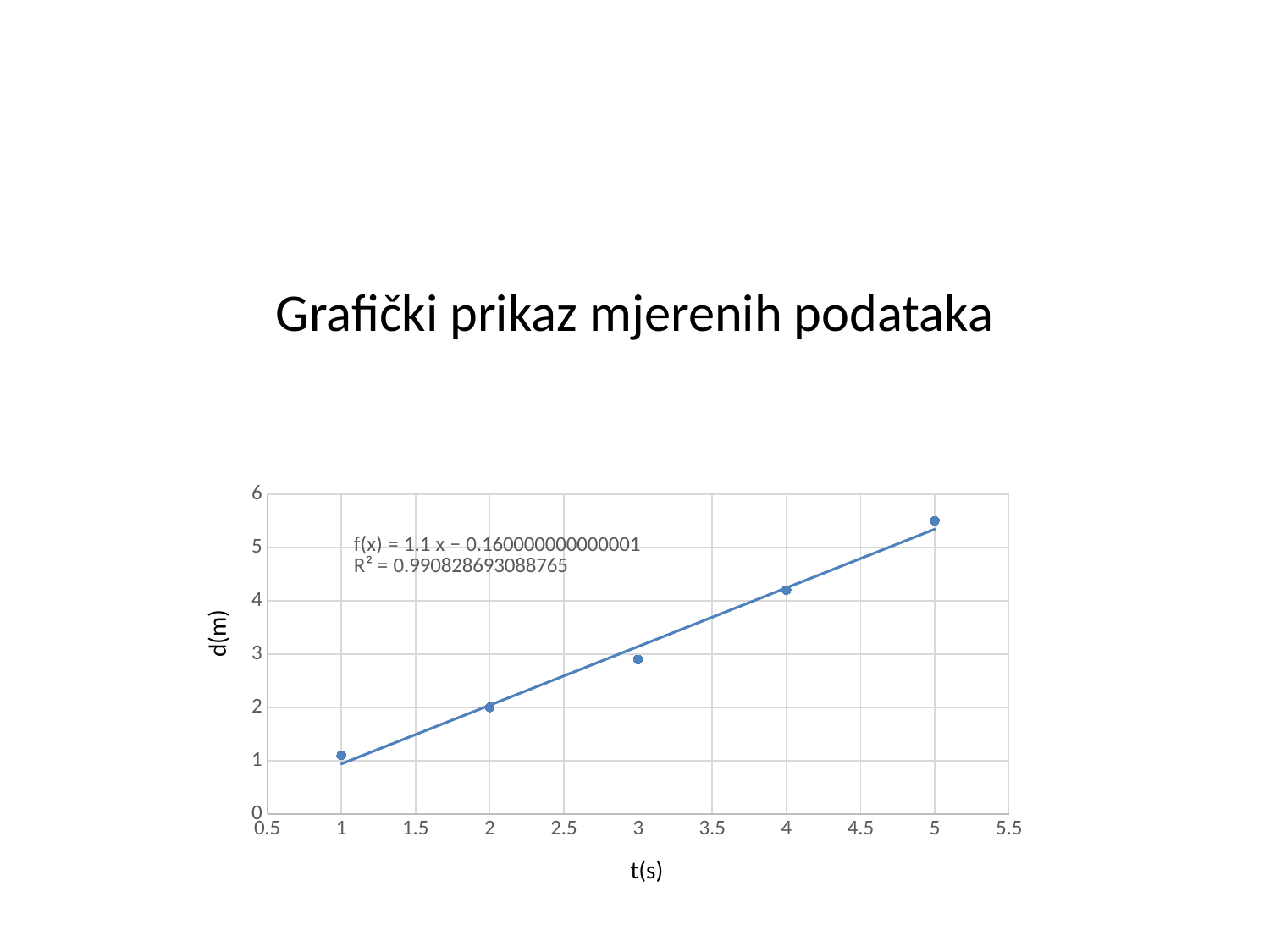
Is the value of d(m) at t = 4 greater or less than 4? greater At which value of t(s) is the plotted d(m) highest? 5 How many data points are plotted on the chart? 5 Is the value of d(m) at t = 3 greater or less than 4? less What is the title of the slide above the chart? Grafički prikaz mjerenih podataka Is the value of d(m) at t = 1 greater or less than 2? less Do the plotted values of d(m) rise or fall as t(s) increases? rise What is the R² value printed on the chart? 0.990828693088765 Which has the larger d(m) value, the point at t = 4 or the point at t = 2? t = 4 What kind of chart is shown on the slide? scatter chart At which value of t(s) is the plotted d(m) lowest? 1